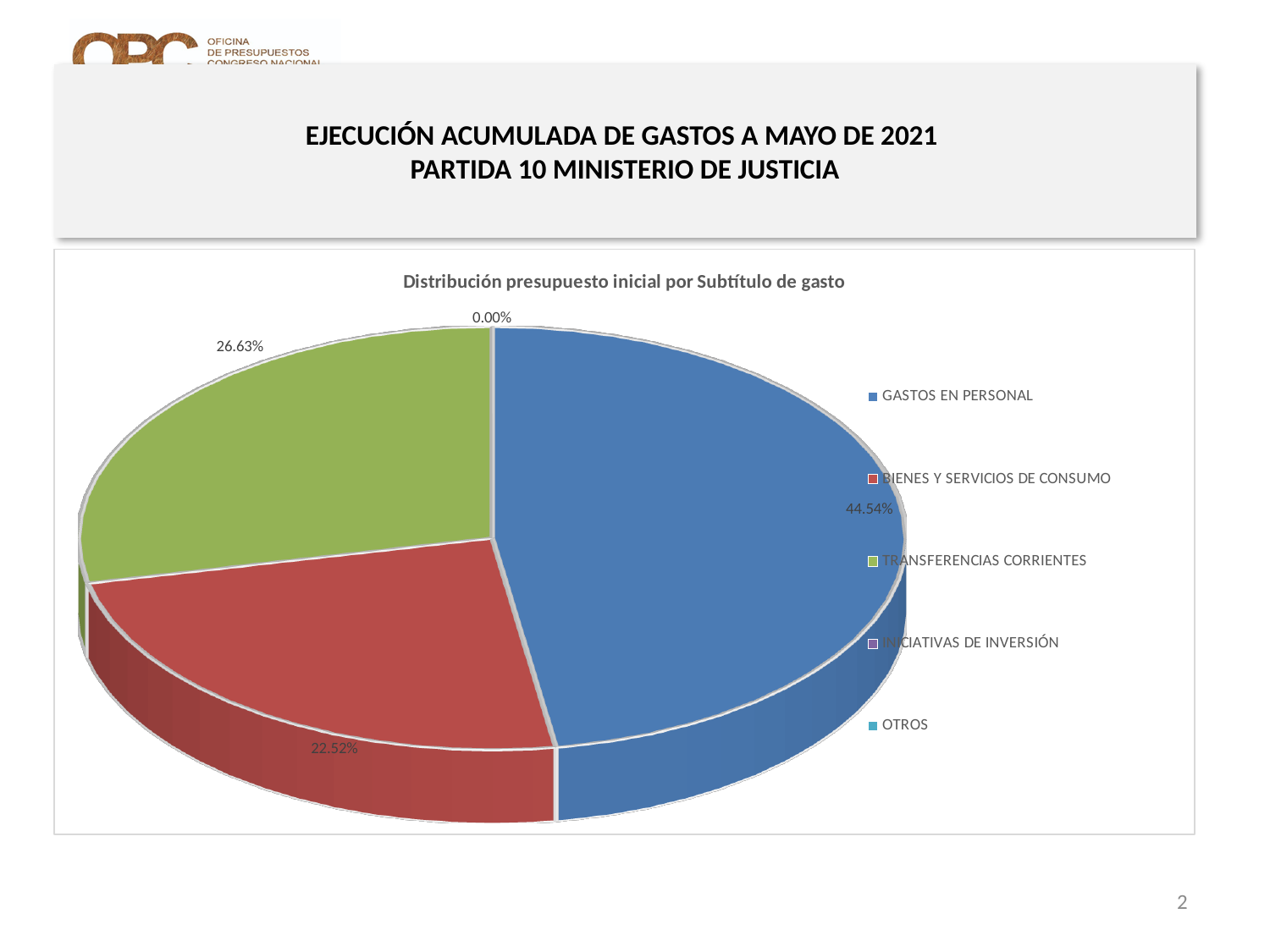
What percentage is shown for TRANSFERENCIAS CORRIENTES? 26.63% How many entries does the legend list? 5 What share of the pie does GASTOS EN PERSONAL represent? 44.54% Which category has the largest slice of the pie? GASTOS EN PERSONAL What colour is the slice for GASTOS EN PERSONAL? blue Which is larger, the slice for TRANSFERENCIAS CORRIENTES or the slice for BIENES Y SERVICIOS DE CONSUMO? TRANSFERENCIAS CORRIENTES What type of chart is shown on the slide? pie chart What percentage is shown for BIENES Y SERVICIOS DE CONSUMO? 22.52% What is the difference in percentage points between TRANSFERENCIAS CORRIENTES and BIENES Y SERVICIOS DE CONSUMO? 4.11% What is the title of the chart? Distribución presupuesto inicial por Subtítulo de gasto What is the difference in percentage points between GASTOS EN PERSONAL and BIENES Y SERVICIOS DE CONSUMO? 22.02% What percentage is shown for GASTOS EN PERSONAL? 44.54%